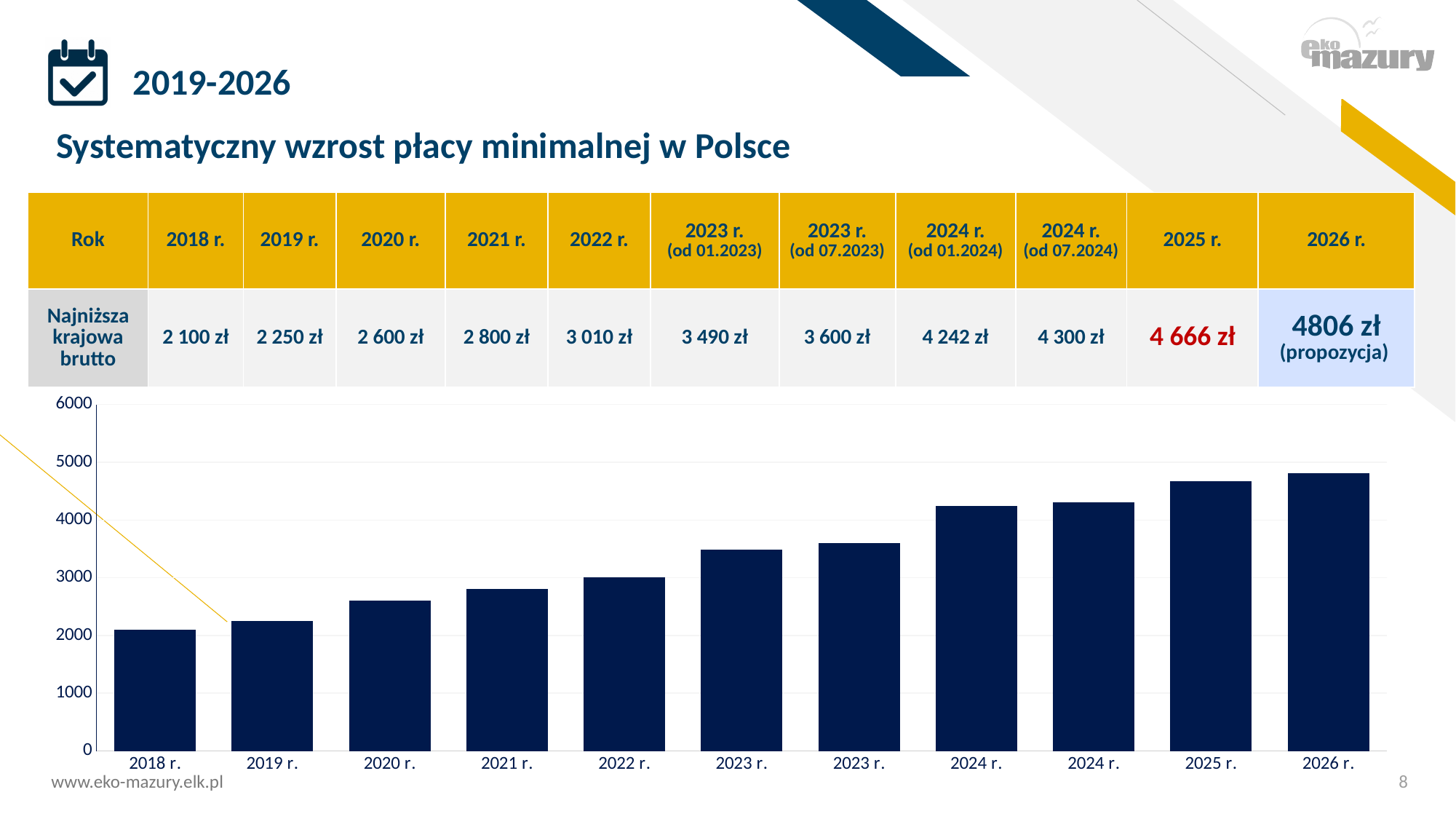
Do the bar values rise or fall from 2018 r. to 2026 r.? rise What is the minimum wage value for 2025 r.? 4 666 zł What is the proposed minimum wage value for 2026 r.? 4806 zł Which year has the lowest bar in the chart? 2018 r. How many bars does the chart have? 11 What is the minimum wage value for 2018 r.? 2 100 zł Which year has the highest bar in the chart? 2026 r. Is the bar for 2024 r. (od 01.2024) greater or less than 4000? greater Which is larger, the value for 2020 r. or the value for 2021 r.? 2021 r. What is the difference between the 2025 r. value and the 2018 r. value? 2 566 zł What kind of chart is shown on the slide? bar chart